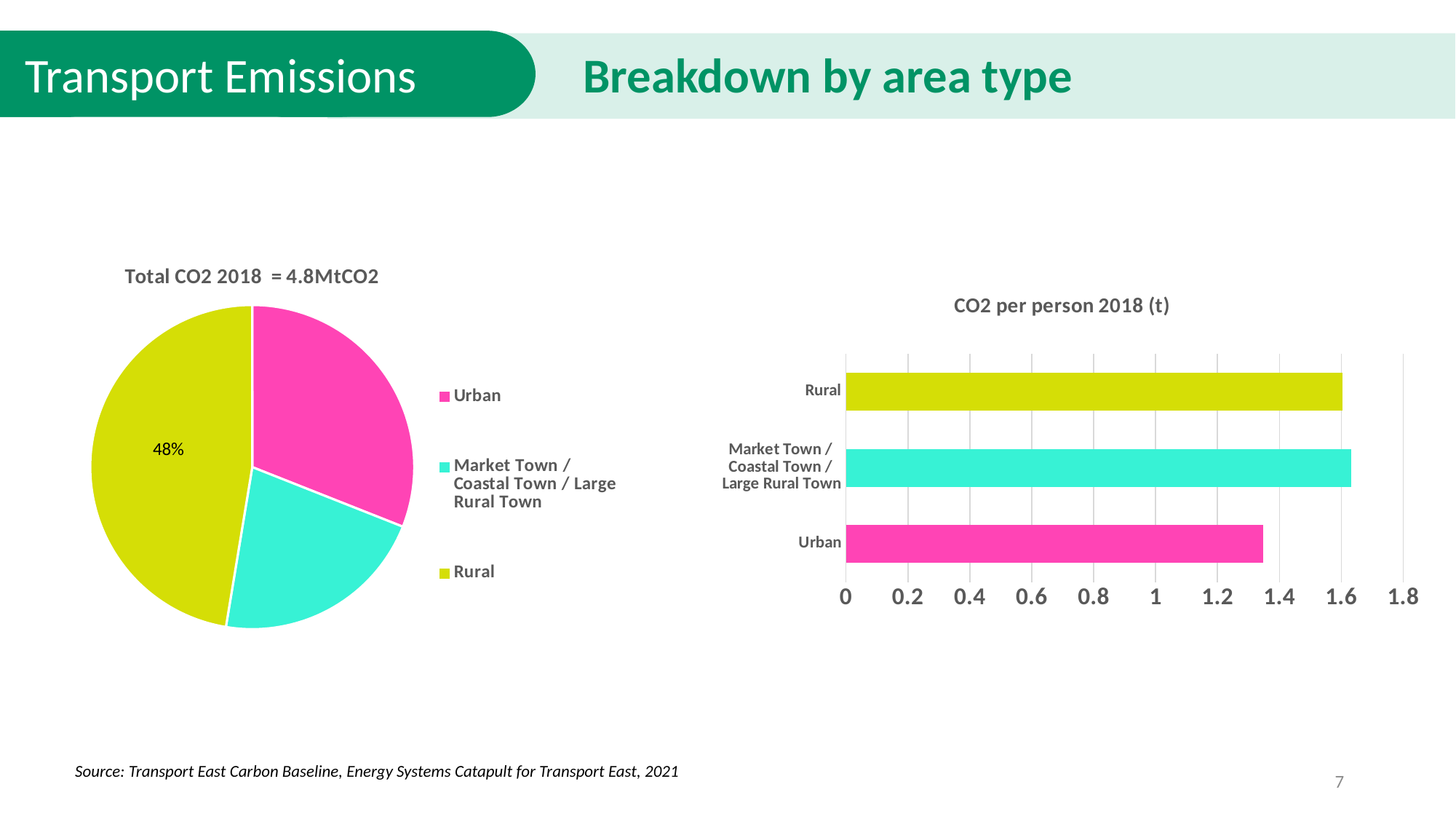
How many slices does the pie chart on the left have? 3 On the pie chart, which area type has the largest share of total CO2? Rural What total CO2 figure for 2018 is given in the pie chart's title? 4.8MtCO2 On the 'CO2 per person 2018 (t)' chart, is the value for Urban greater or less than 1.2? greater On the 'CO2 per person 2018 (t)' chart, what colour is the Rural bar? yellow-green On the 'CO2 per person 2018 (t)' chart, which area type has the lowest CO2 per person? Urban On the 'CO2 per person 2018 (t)' chart, is the value for Market Town / Coastal Town / Large Rural Town greater or less than 1.4? greater How many bars are shown on the 'CO2 per person 2018 (t)' chart? 3 What kind of chart is the 'CO2 per person 2018 (t)' chart on the right? bar chart On the pie chart titled 'Total CO2 2018 = 4.8MtCO2', what share of emissions comes from Rural areas? 48% On the pie chart, which slice is larger: Urban or Market Town / Coastal Town / Large Rural Town? Urban On the 'CO2 per person 2018 (t)' chart, is the value for Rural greater or less than 1.4? greater